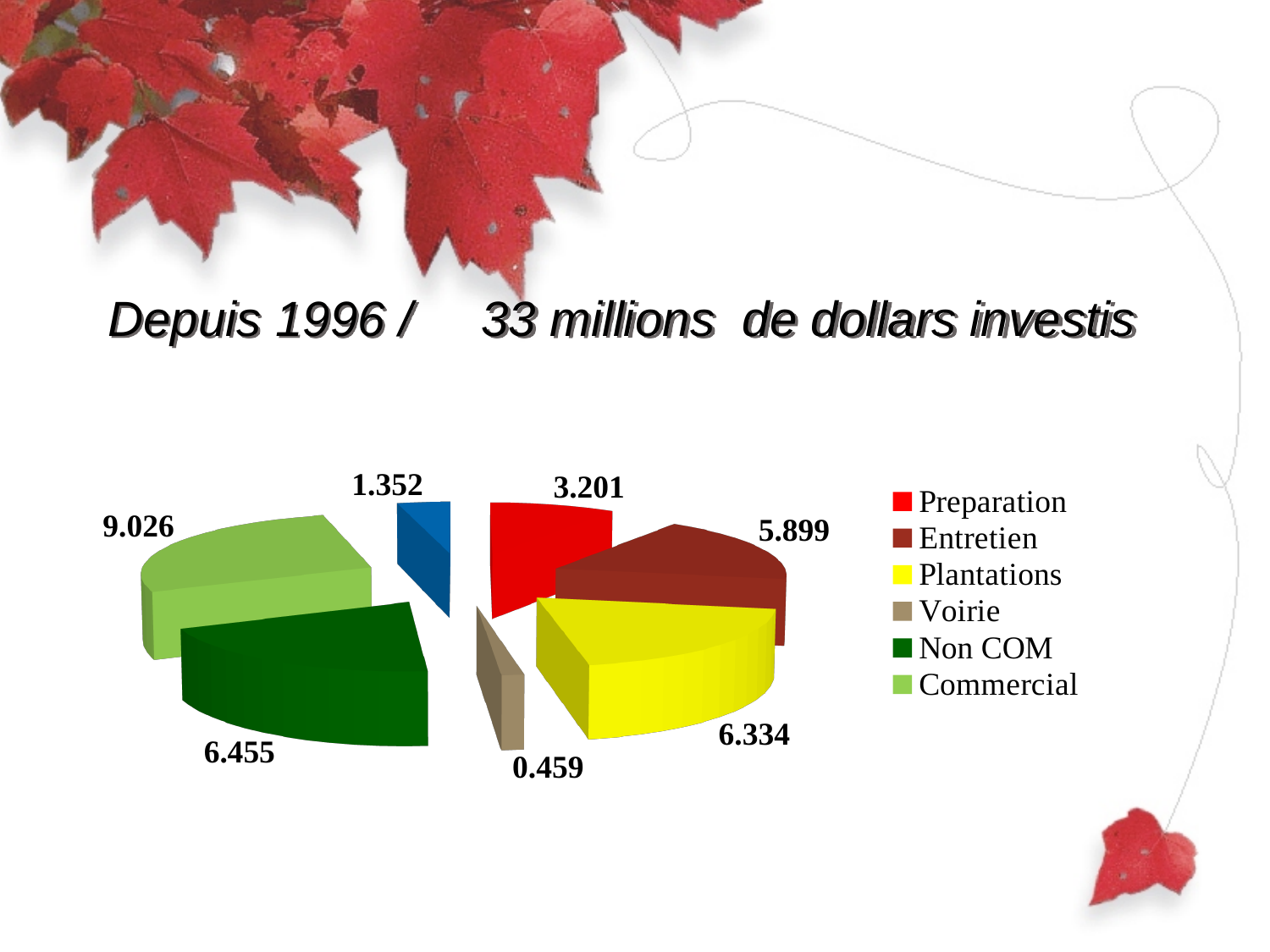
What kind of chart is shown on the slide? pie chart How many entries does the legend list? 6 What is the value for Entretien? 5.899 Which is larger, the value for Non COM or the value for Plantations? Non COM Which legend category has the largest slice? Commercial Which legend category has the smallest slice? Voirie What is the value for Voirie? 0.459 What is the value for Preparation? 3.201 What is the difference between the values for Commercial and Preparation? 5.825 What is the value for Non COM? 6.455 What is the value for Commercial? 9.026 What is the value for Plantations? 6.334